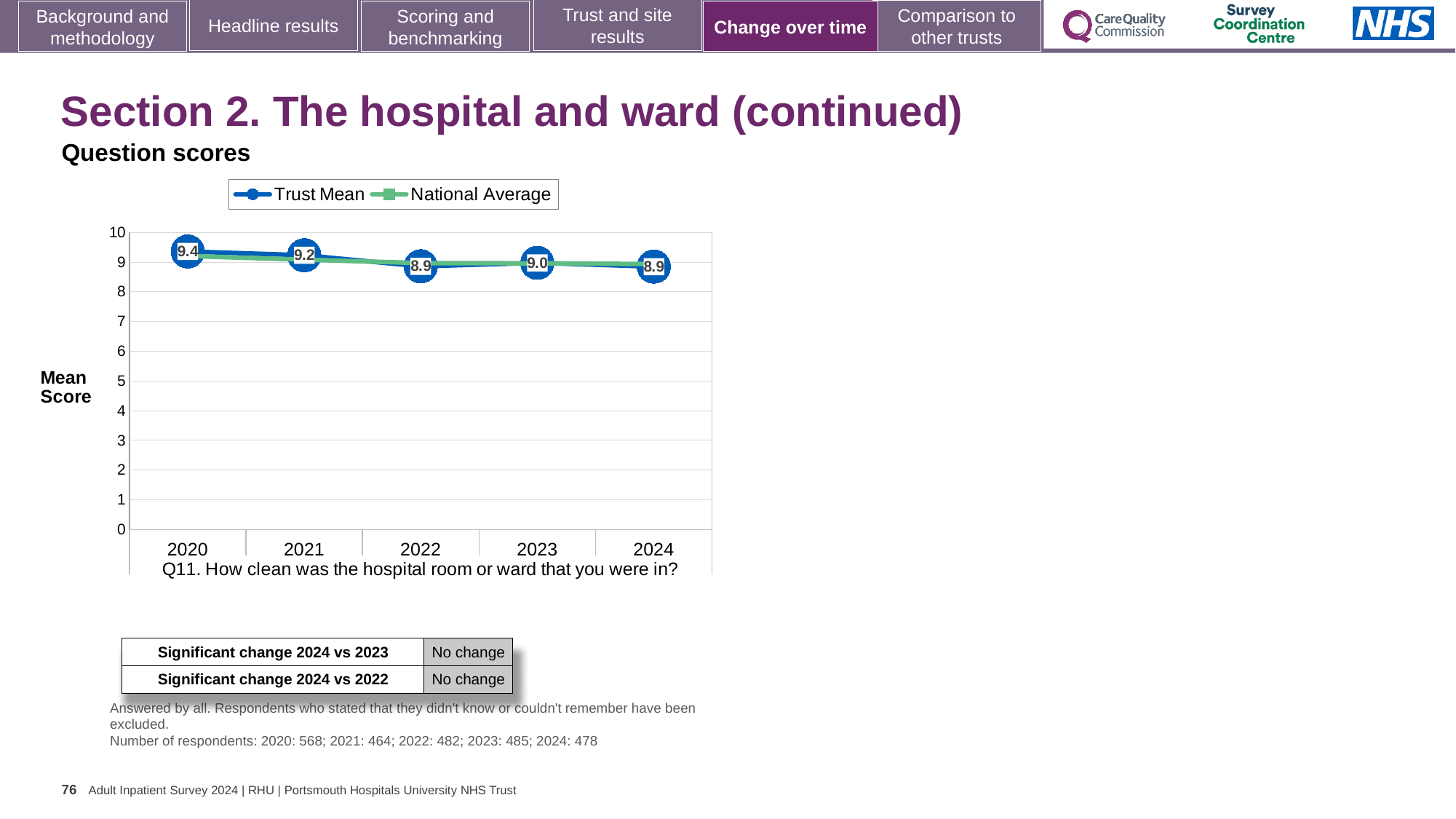
In which year is the Trust Mean highest? 2020 What is the Trust Mean value for 2020? 9.4 Which is larger, the Trust Mean for 2020 or for 2021? 2020 What is the difference between the Trust Mean in 2020 and in 2024? 0.5 Is the National Average value for 2020 greater or less than 9? greater What is the Trust Mean value for 2023? 9.0 What kind of chart is shown on the slide? Line chart How many years are shown on the x axis? 5 What is the Trust Mean value for 2022? 8.9 What is the label on the y axis of the chart? Mean Score Does the Trust Mean rise or fall overall from 2020 to 2024? Fall How many series does the legend list? 2